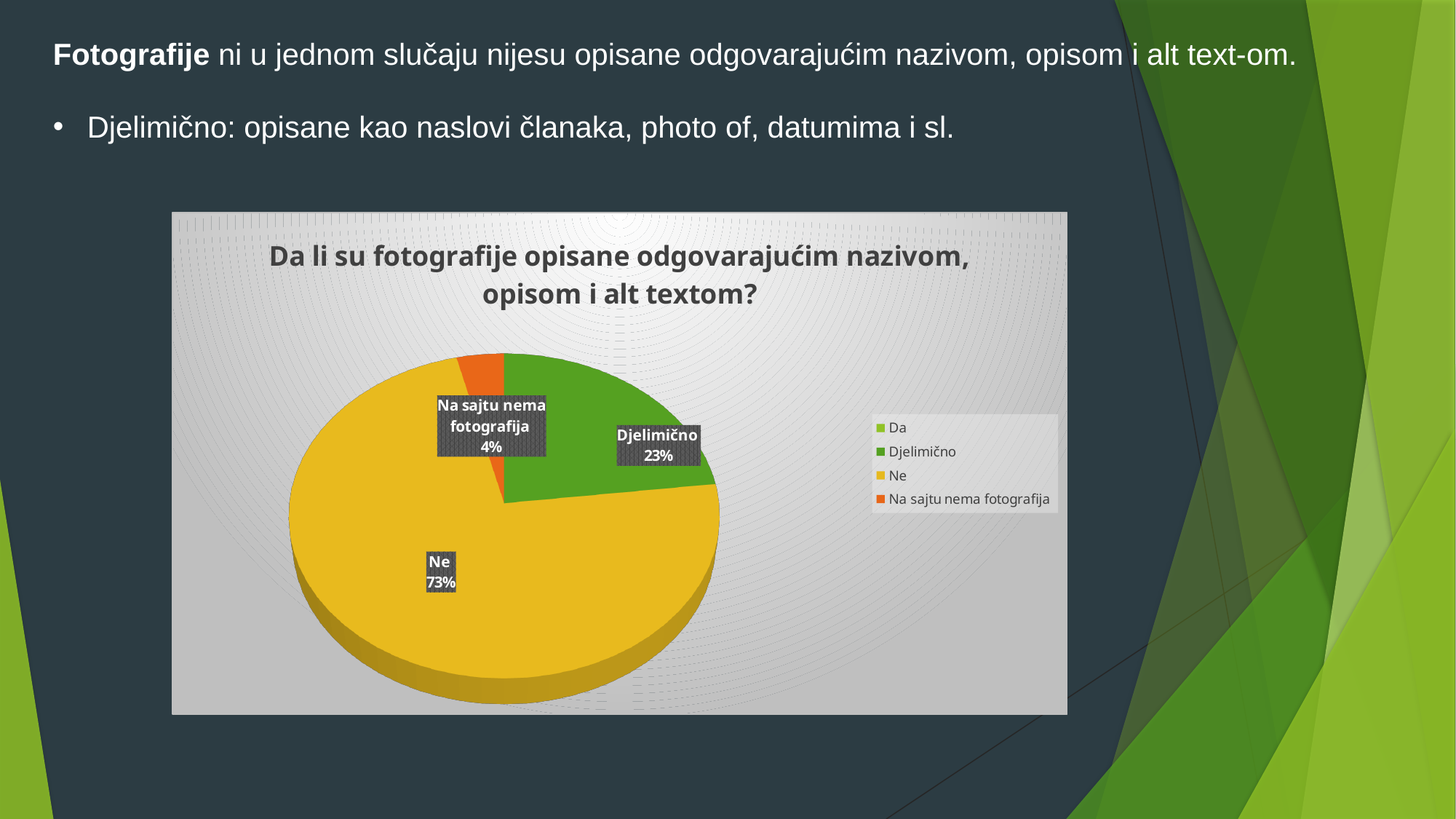
What share of the pie does the "Djelimično" slice represent? 23% What is the title of the chart? Da li su fotografije opisane odgovarajućim nazivom, opisom i alt textom? What share of the pie does the "Na sajtu nema fotografija" slice represent? 4% How many slices with data labels are visible in the pie? 3 What colour is the "Ne" slice of the pie? yellow What share of the pie does the "Ne" slice represent? 73% How many entries does the chart legend list? 4 Which slice is larger, "Djelimično" or "Na sajtu nema fotografija"? Djelimično What is the difference in percentage points between the "Ne" slice and the "Djelimično" slice? 50 Which category has the largest slice of the pie? Ne Which labelled slice of the pie is the smallest? Na sajtu nema fotografija What kind of chart is shown on the slide? pie chart